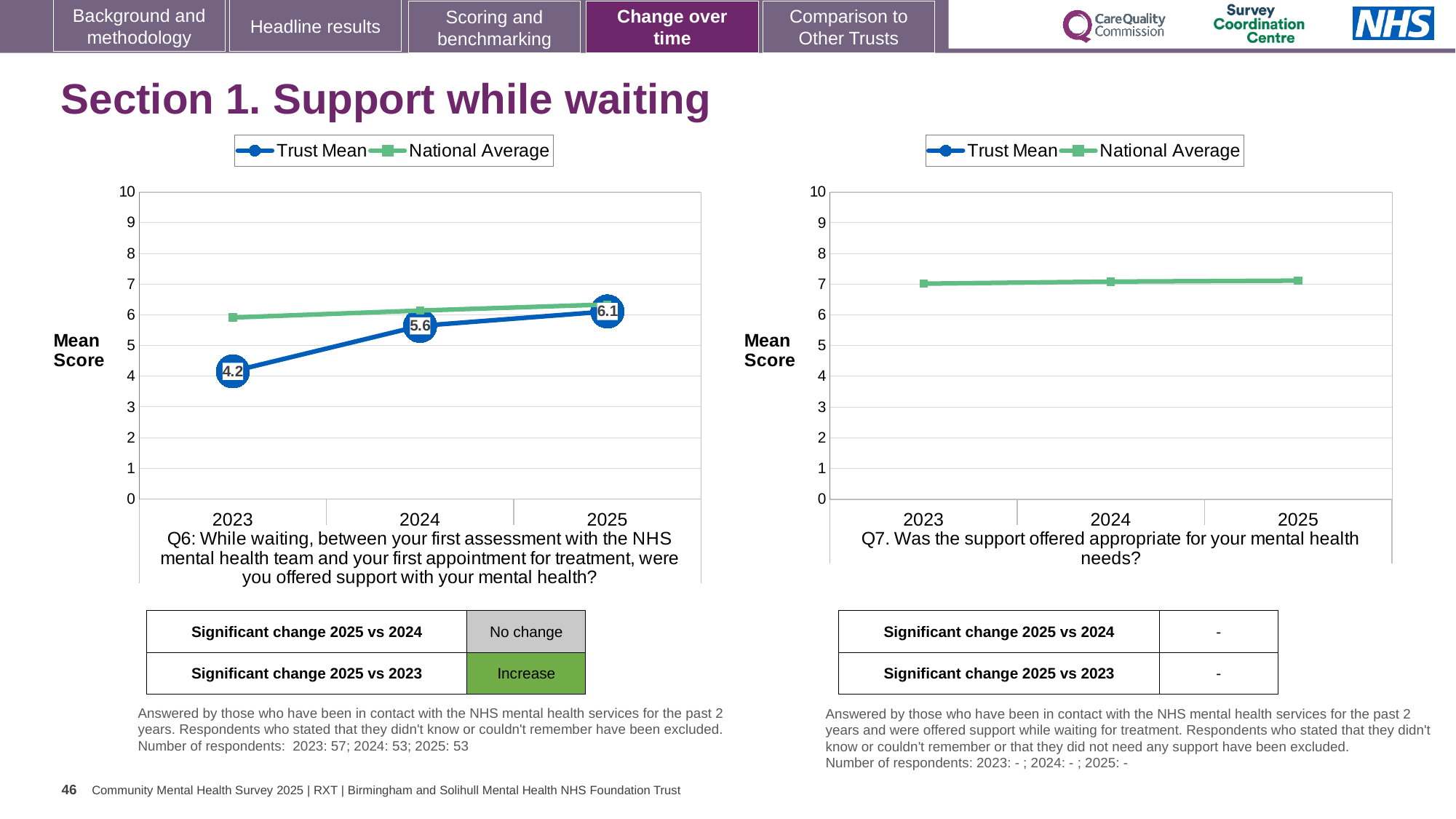
What kind of chart is the Q6 chart on the left? line chart In the Q6 chart on the left, what is the Trust Mean score for 2025? 6.1 In the Q6 chart on the left, which year has the highest Trust Mean score? 2025 In the Q6 chart on the left, what is the Trust Mean score for 2024? 5.6 In the Q6 chart on the left, does the Trust Mean rise or fall from 2023 to 2025? rise In the Q6 chart on the left, what is the difference between the Trust Mean scores for 2025 and 2023? 1.9 How many series does the legend of the Q7 chart on the right list? 2 In the Q6 chart on the left, which year has the lowest Trust Mean score? 2023 How many years are shown on the x axis of the Q6 chart on the left? 3 In the Q6 chart on the left, which is larger for 2023: the Trust Mean or the National Average? National Average In the Q6 chart on the left, what is the Trust Mean score for 2023? 4.2 In the Q7 chart on the right, is the National Average value for 2023 greater or less than 6? greater